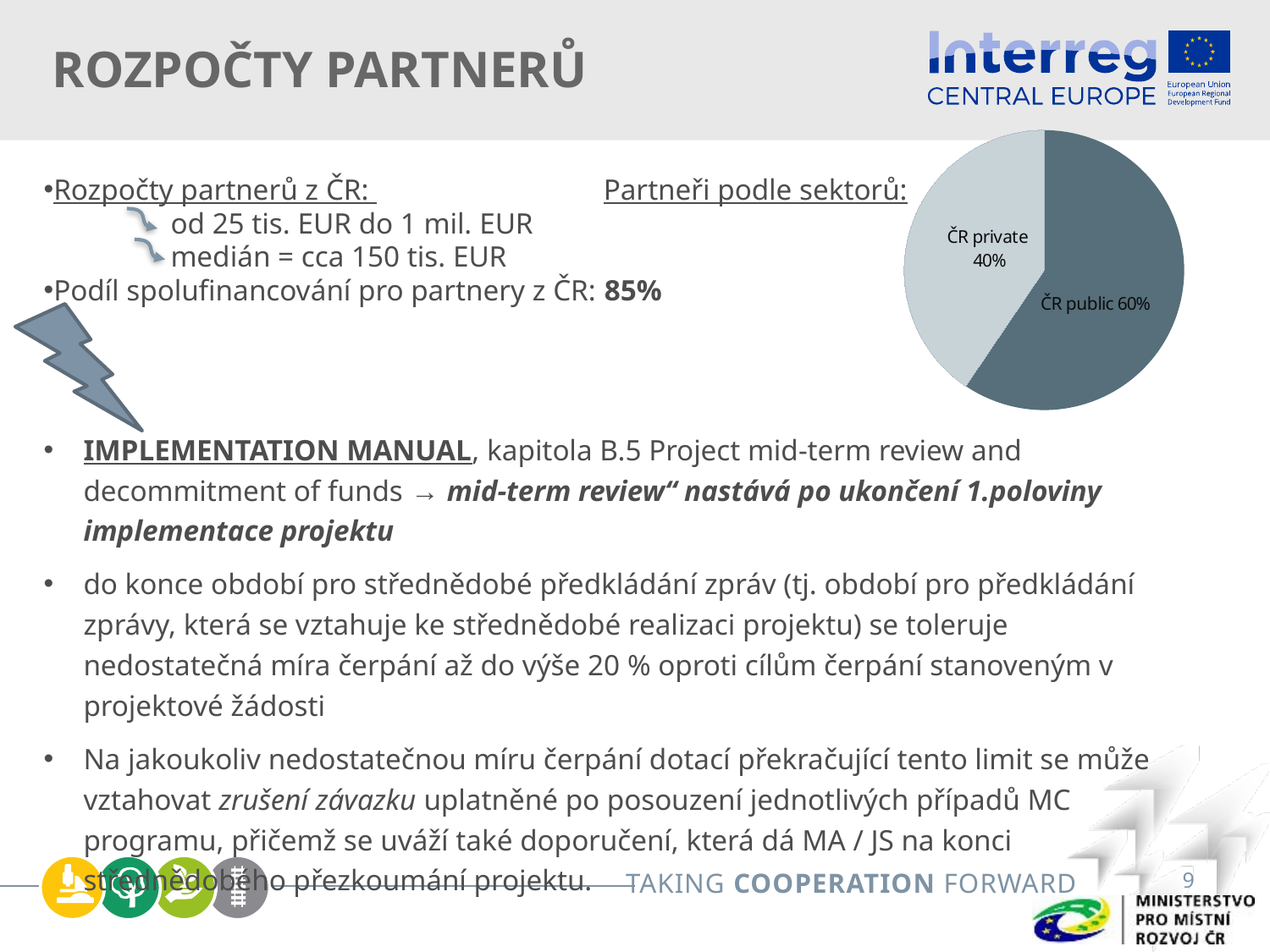
What heading is written above the pie chart? Partneři podle sektorů: How many slices does the pie chart have? 2 Is the share for ČR private greater or less than 50%? less Which slice of the pie chart is the largest? ČR public What share of the pie does ČR public have? 60% Which is larger in the pie chart, ČR private or ČR public? ČR public What is the difference in percentage points between the ČR public and ČR private slices? 20 What kind of chart is shown on the slide? pie chart Which slice of the pie chart is the smallest? ČR private What share of the pie does ČR private have? 40% Which slice of the pie chart is drawn in the darker colour? ČR public